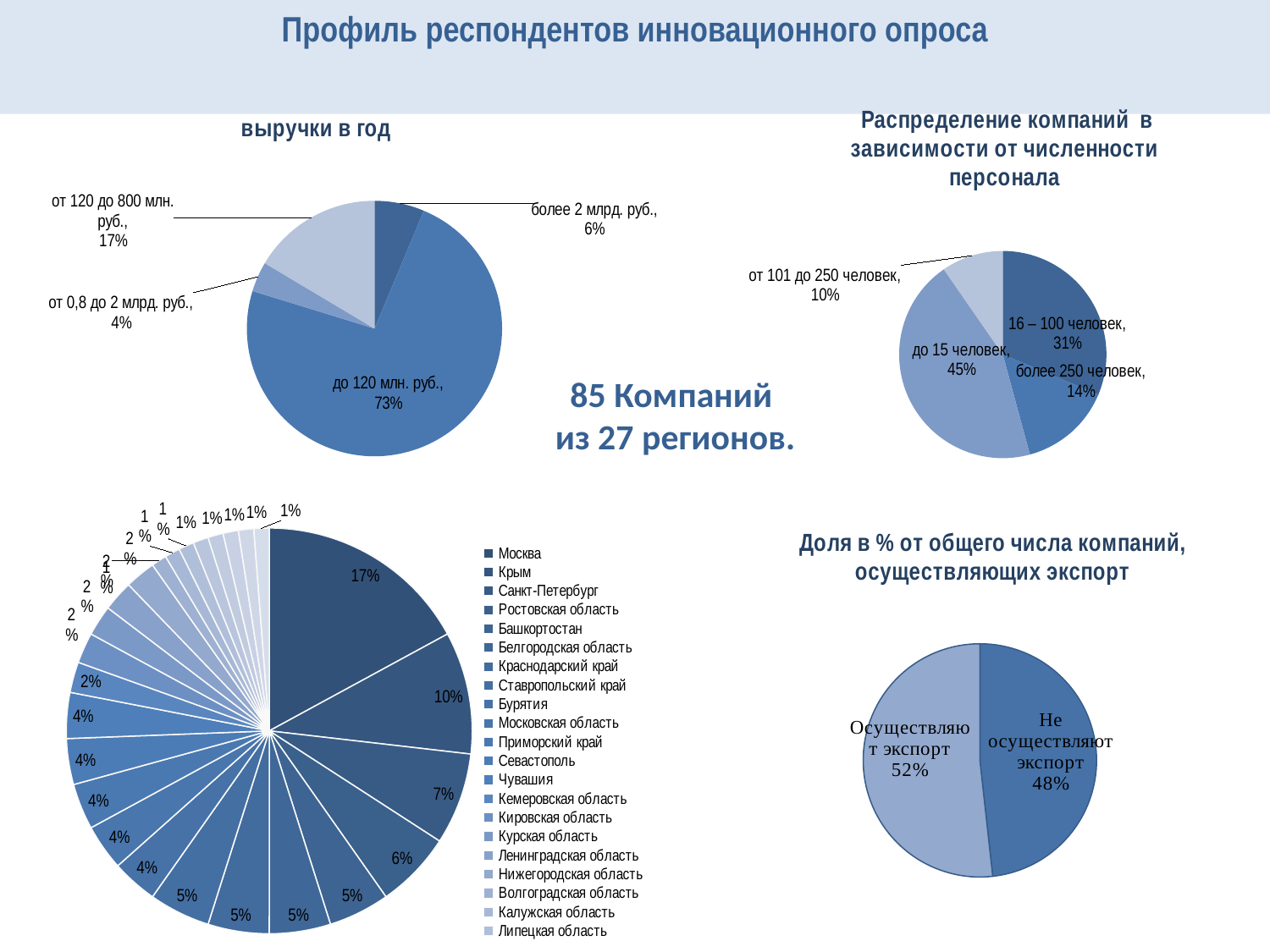
In the bottom-left pie chart of regions, what is the value of the largest slice? 17% In the top-left pie chart on annual revenue, what is the difference in percentage points between the 'от 120 до 800 млн. руб.' slice and the 'более 2 млрд. руб.' slice? 11 percentage points In the top-left pie chart on annual revenue, what share of companies have revenue up to 120 million rubles (до 120 млн. руб.)? 73% In the top-left pie chart on annual revenue, which category has the smallest share? от 0,8 до 2 млрд. руб. In the bottom-right pie chart on exports, which is larger: the share of companies that export or the share that do not export? Осуществляют экспорт In the top-left pie chart on annual revenue, what share of companies have revenue over 2 billion rubles (более 2 млрд. руб.)? 6% In the top-right pie chart on company distribution by personnel size, what share of companies have up to 15 employees (до 15 человек)? 45% In the top-right pie chart on personnel size, how many slices does the pie have? 4 What type of chart is used in the bottom-right chart on the share of exporting companies? Pie chart In the top-right pie chart on personnel size, which category has the smallest share? от 101 до 250 человек In the top-right pie chart on personnel size, what share of companies have 16–100 employees? 31% In the bottom-right pie chart on the share of exporting companies, what share of companies carry out exports (Осуществляют экспорт)? 52%